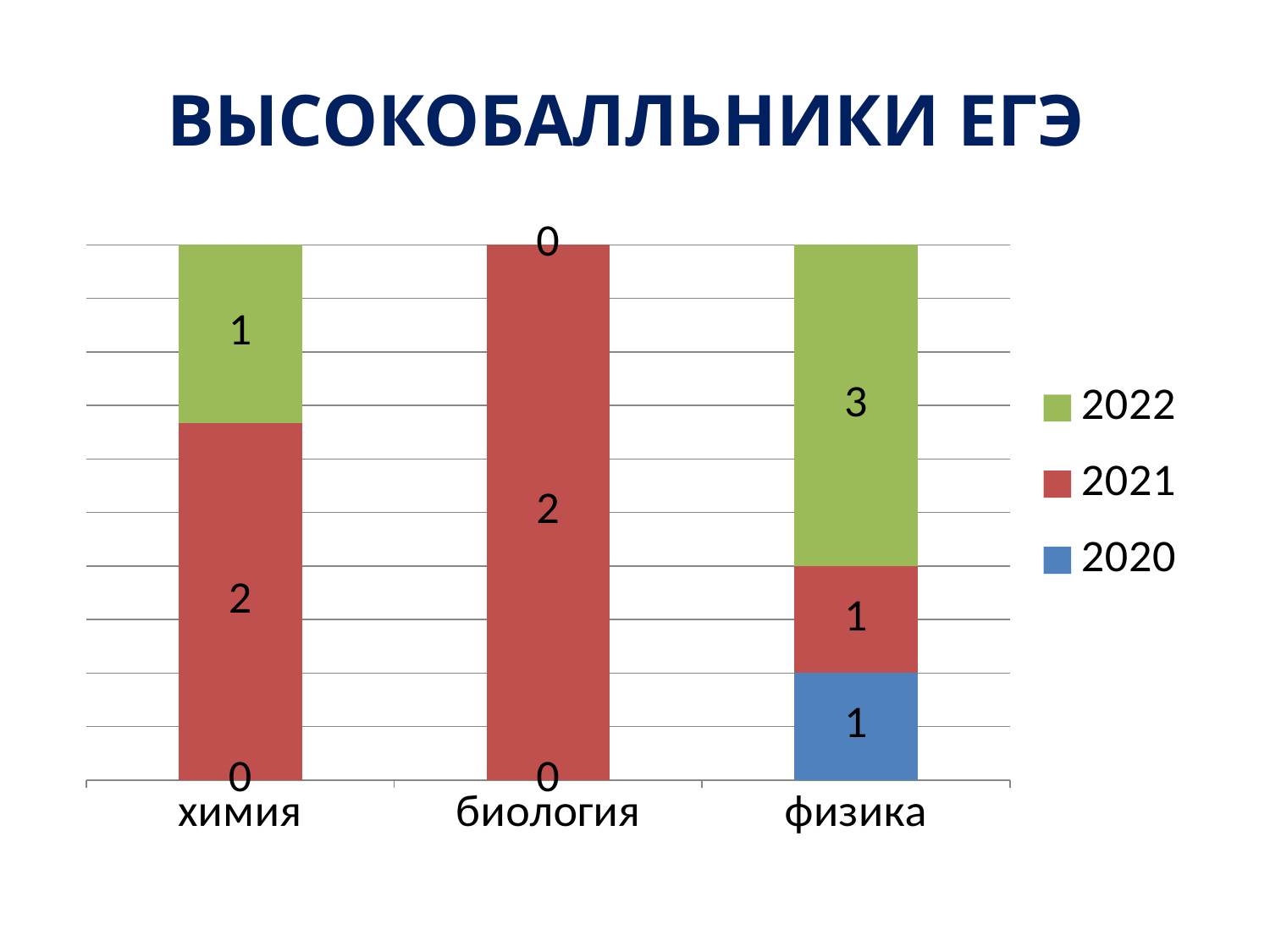
How many series does the legend list? 3 What is the title of the chart? ВЫСОКОБАЛЛЬНИКИ ЕГЭ What is the total of the stacked bar for химия? 3 What is the total of the stacked bar for физика? 5 What type of chart is shown on the slide? Stacked bar chart What is the value for 2021 in the химия bar? 2 Which category has the highest value for 2022? физика How many categories are shown on the x axis? 3 What is the value for 2020 in the биология bar? 0 What is the difference between the 2022 values for физика and химия? 2 What is the value for 2022 in the физика bar? 3 What is the value for 2020 in the физика bar? 1